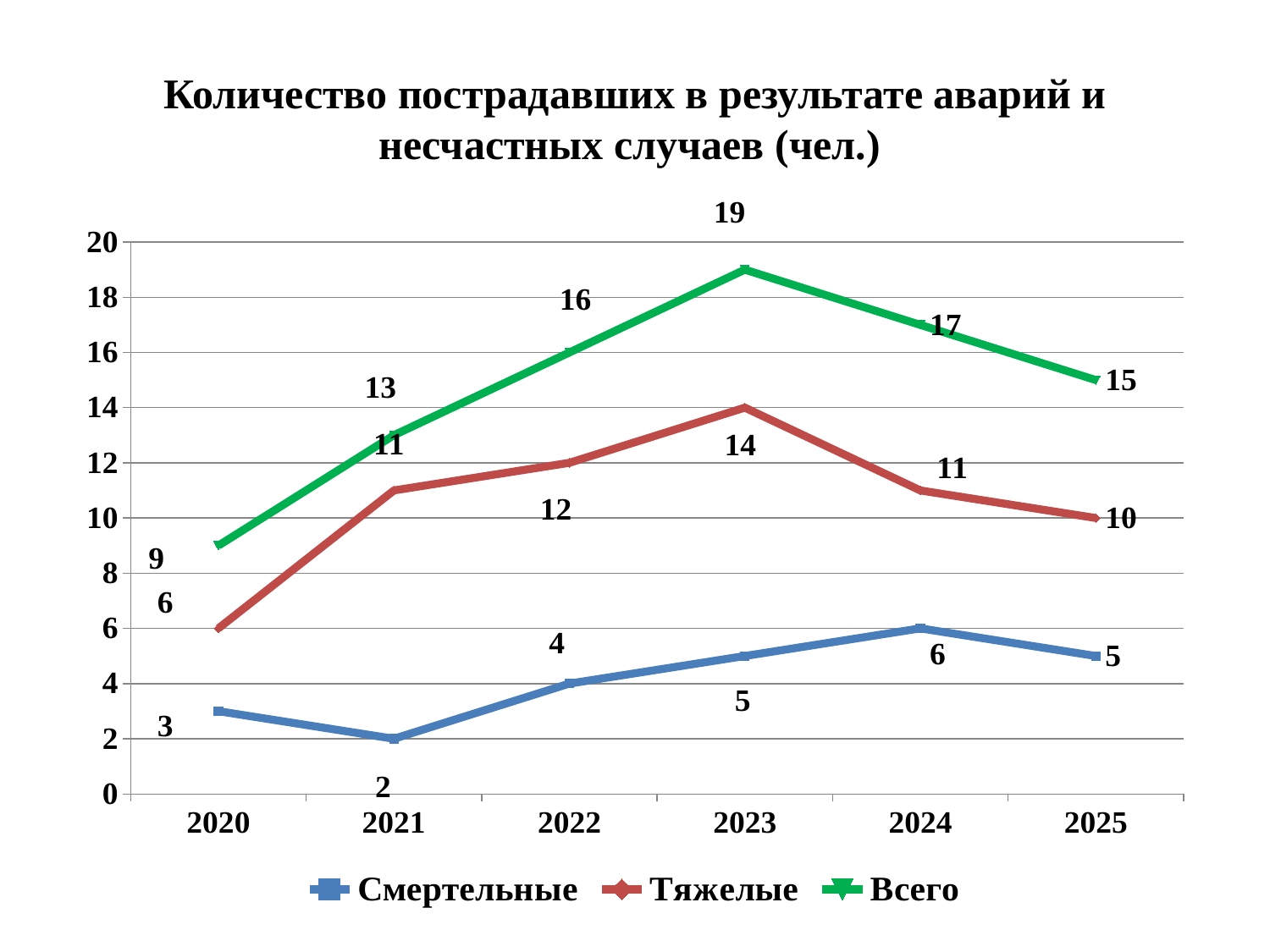
What is the title of the chart? Количество пострадавших в результате аварий и несчастных случаев (чел.) How many series does the legend list? 3 What is the difference between the Всего value in 2023 and the Всего value in 2020? 10 What is the value of the Смертельные series in 2024? 6 What is the value of the Тяжелые series in 2021? 11 Does the Всего series rise or fall from 2023 to 2025? Fall What is the value of the Всего series in 2023? 19 What kind of chart is shown on the slide? Line chart How many years are shown on the x axis? 6 In which year is the Смертельные series at its lowest? 2021 Which is larger: the Тяжелые value in 2022 or the Тяжелые value in 2025? 2022 In which year is the Всего series at its highest? 2023